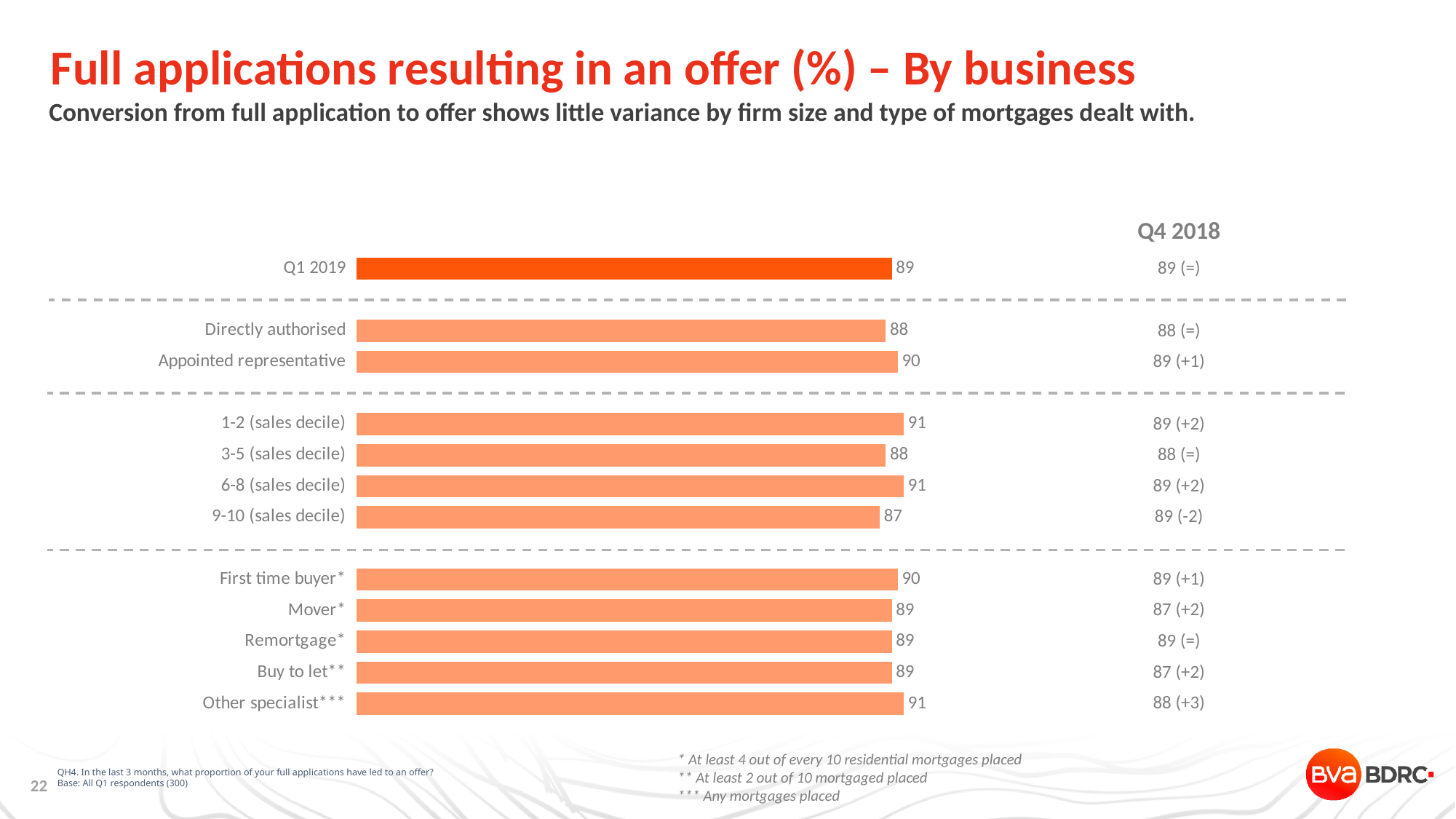
Which category has the lowest value? 9-10 (sales decile) What is the value for 9-10 (sales decile)? 87 What is the value for Q1 2019 overall? 89 What was the Q4 2018 value shown for Mover? 87 (+2) What is the difference between the values for First time buyer and Mover? 1 What is the value for Other specialist? 91 What is the value for Appointed representative? 90 Which bar is drawn in a darker orange than the others? Q1 2019 What is the difference between the values for 1-2 (sales decile) and 9-10 (sales decile)? 4 What kind of chart is shown on the slide? Bar chart How many bars are plotted on the chart? 12 Which is larger, the value for Directly authorised or the value for Appointed representative? Appointed representative